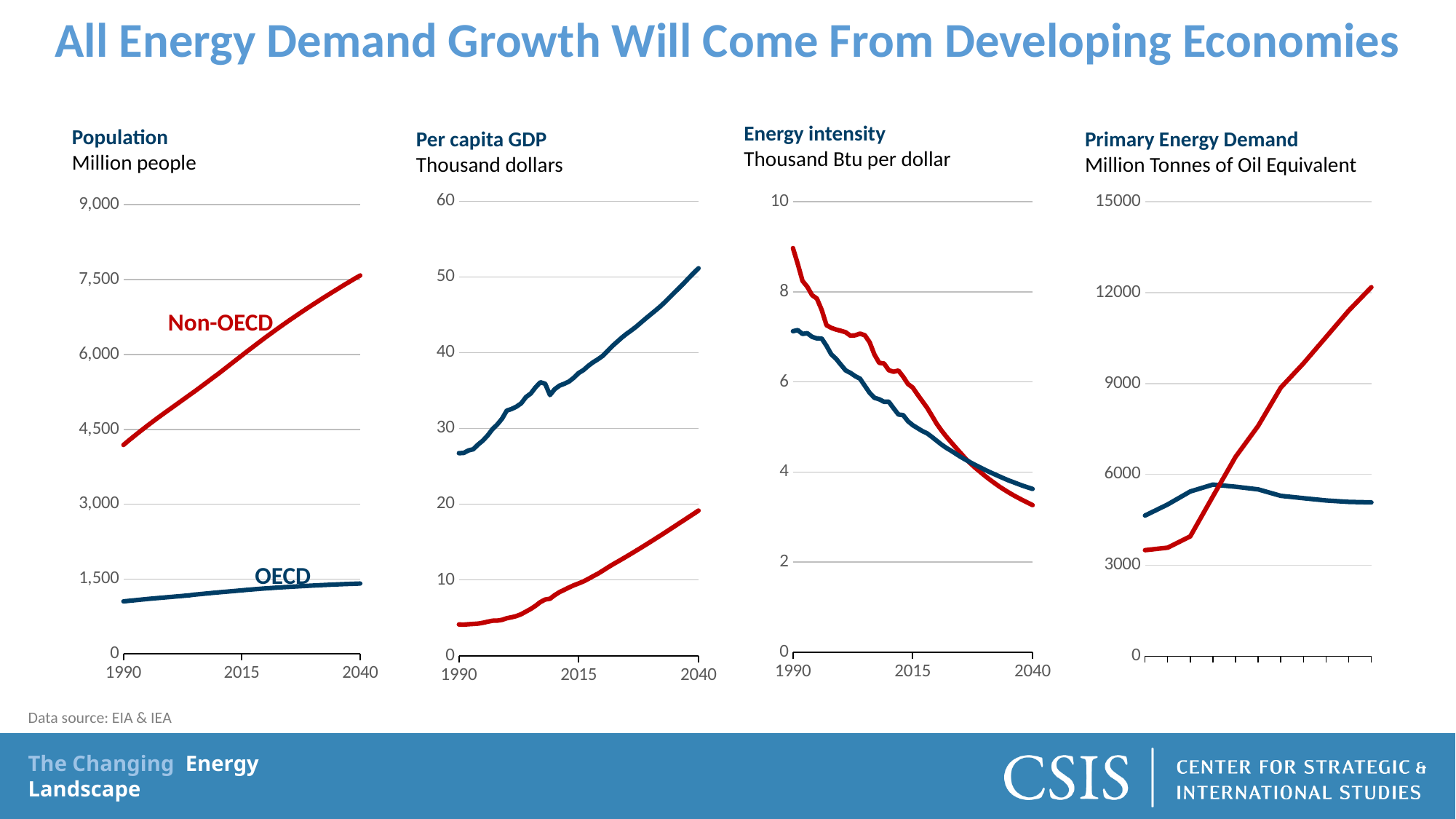
How many charts are shown on the slide? 4 In the Energy intensity chart, does the OECD line rise or fall from 1990 to 2040? fall What kind of chart is the Population chart? line chart In the Population chart, is the OECD value in 2040 greater or less than 3,000? less In the Population chart, does the Non-OECD line rise or fall from 1990 to 2040? rise In the Per capita GDP chart, which is larger in 2040, OECD or Non-OECD? OECD In the Population chart, is the Non-OECD value in 2040 greater or less than 6,000? greater In the Energy intensity chart, is the Non-OECD value in 1990 greater or less than 8? greater In the Primary Energy Demand chart, which is larger at the end of the period, Non-OECD or OECD? Non-OECD What unit is used in the Primary Energy Demand chart? Million Tonnes of Oil Equivalent